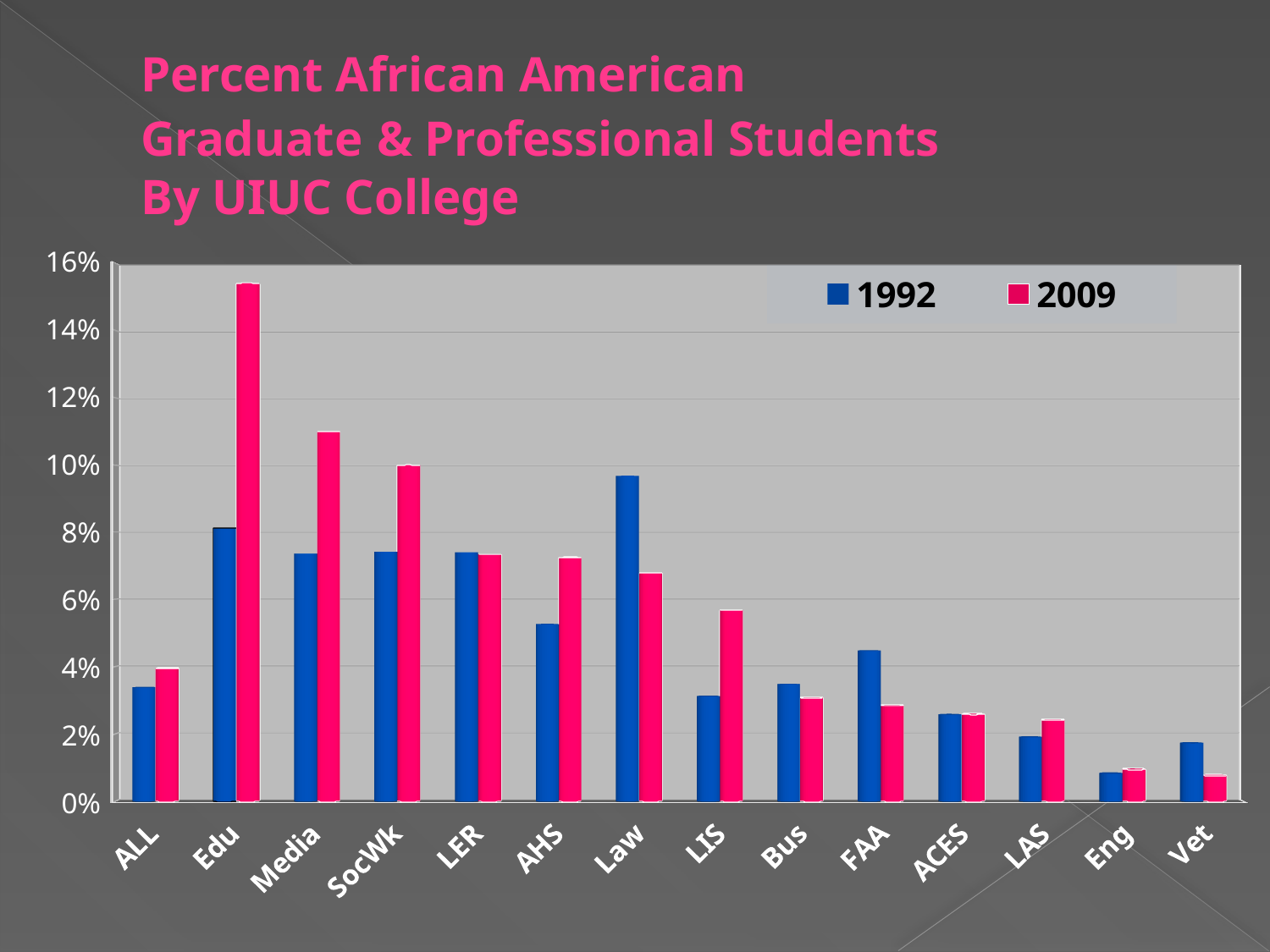
Which college has the lowest value for 1992? Eng What kind of chart is shown on the slide? bar chart Which college has the highest value for 2009? Edu Is the 1992 value for Law greater or less than 8%? greater How many colleges (categories) are shown on the x axis? 14 Which college has the highest value for 1992? Law Is the 2009 value for Vet greater or less than 2%? less For Law, which year has the larger value, 1992 or 2009? 1992 Which colour represents the 2009 series in the legend? pink How many series does the legend list? 2 For FAA, which year has the larger value, 1992 or 2009? 1992 Is the 2009 value for Edu greater or less than 14%? greater